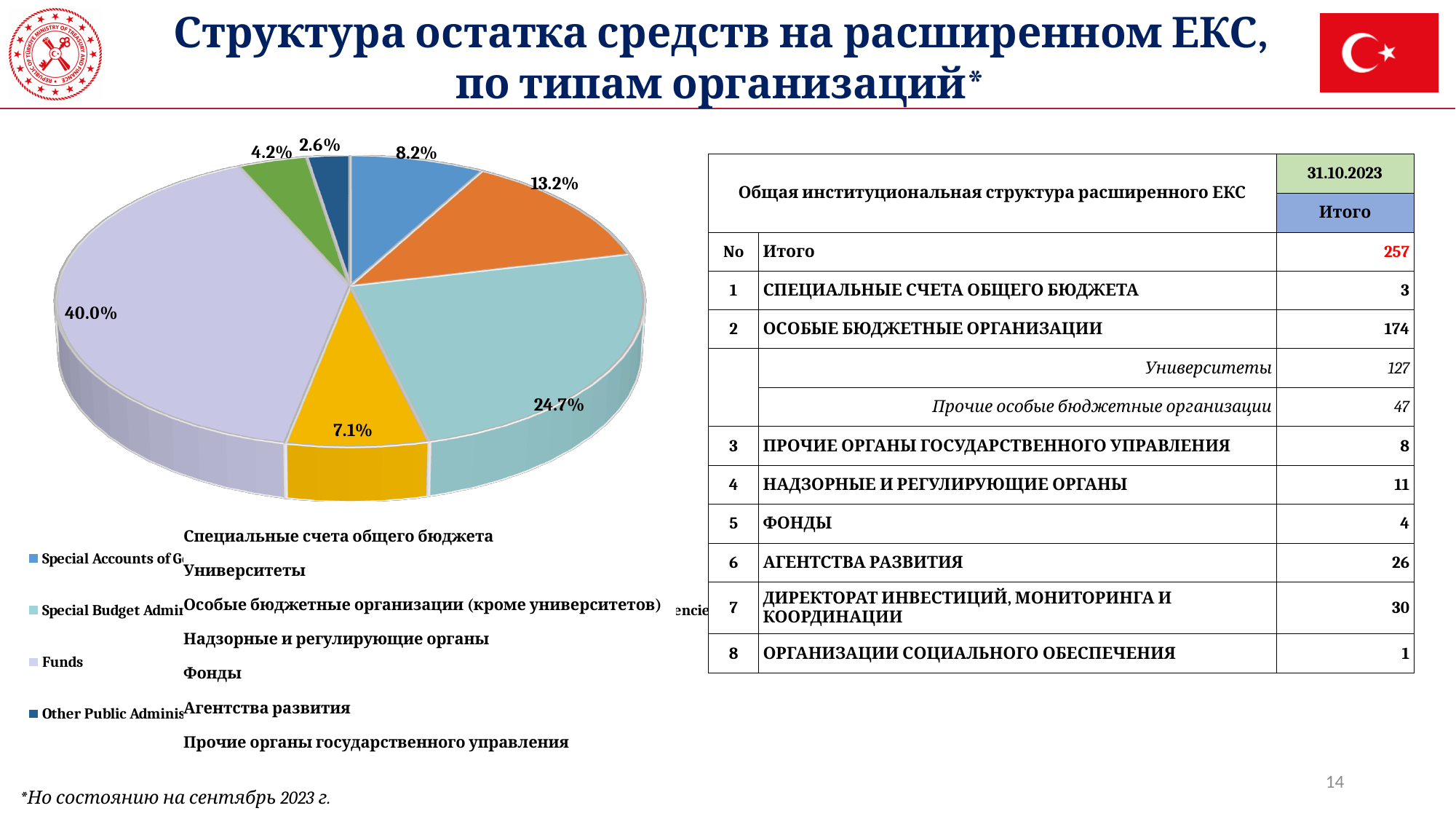
What is the largest share shown in the pie chart? 40.0% What is the smallest share shown in the pie chart? 2.6% Which slice is larger in the pie chart: Funds or Special Budget Administrations? Funds What is the difference in percentage points between the Special Accounts of General Budget slice and the Other Public Administrations slice? 5.6 percentage points What share of the pie chart does the Special Budget Administrations slice represent? 24.7% How many slices does the pie chart have? 7 What colour is the Funds slice in the pie chart? Light purple (lavender) What share of the pie chart does the Funds slice represent? 40.0% What kind of chart is shown on the left of the slide? Pie chart What share of the pie chart does the Special Accounts of General Budget slice represent? 8.2% What is the difference in percentage points between the Funds slice and the Special Budget Administrations slice? 15.3 percentage points